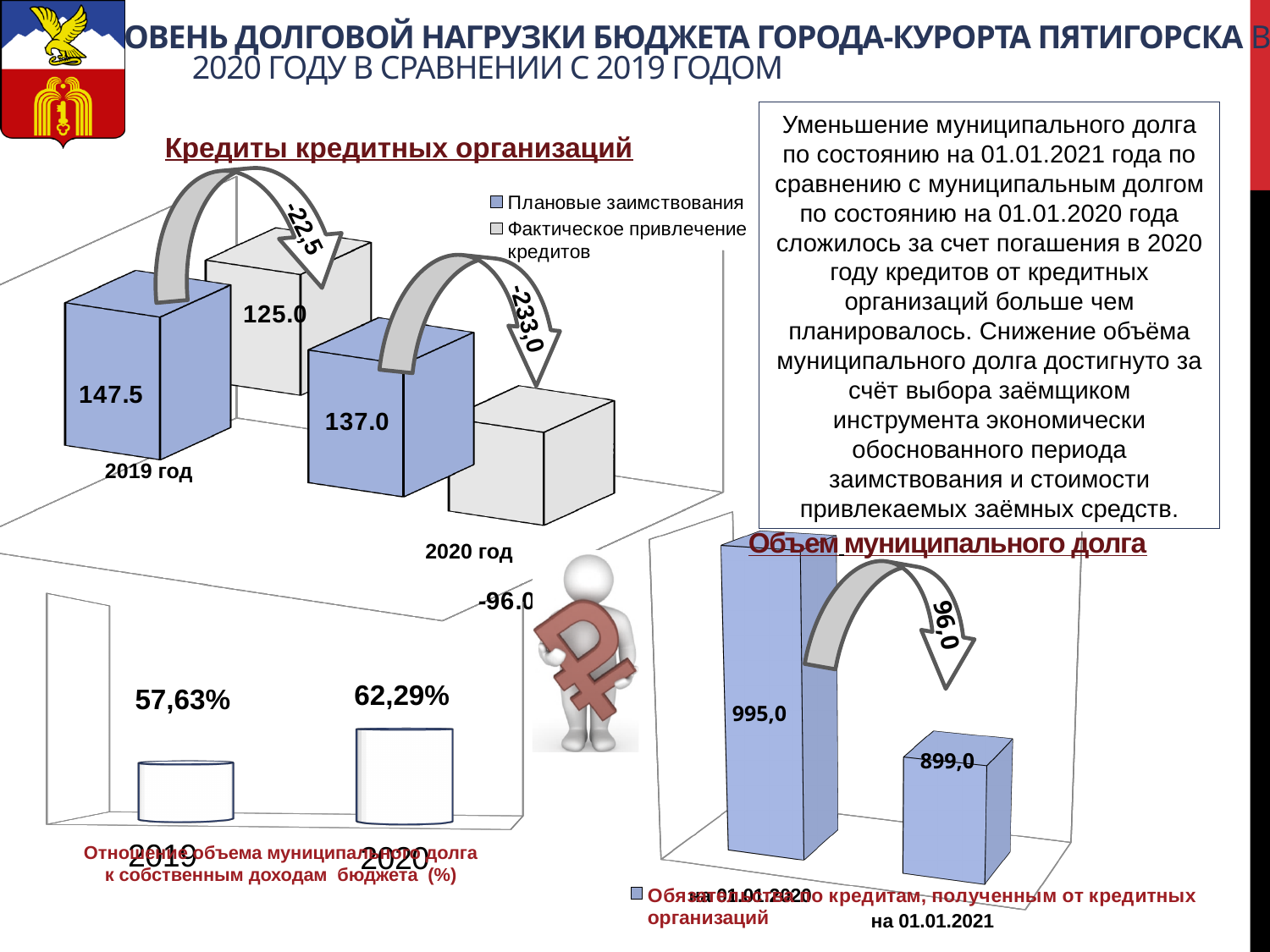
In the chart 'Объем муниципального долга', what is the value for 'на 01.01.2020'? 995,0 In the bottom-left chart 'Отношение объема муниципального долга к собственным доходам бюджета (%)', what is the value for 2019? 57,63% In the chart 'Объем муниципального долга', what is the value for 'на 01.01.2021'? 899,0 In the chart 'Кредиты кредитных организаций', what is the value of 'Плановые заимствования' for 2019 год? 147.5 In the chart 'Объем муниципального долга', by how much did the value decrease from 'на 01.01.2020' to 'на 01.01.2021'? 96,0 In the chart 'Кредиты кредитных организаций', what is the value of 'Плановые заимствования' for 2020 год? 137.0 In the bottom-left chart 'Отношение объема муниципального долга к собственным доходам бюджета (%)', what is the value for 2020? 62,29% How many series does the legend of the chart 'Кредиты кредитных организаций' list? 2 In the chart 'Кредиты кредитных организаций', what is the value of 'Фактическое привлечение кредитов' for 2019 год? 125.0 In the bottom-left chart 'Отношение объема муниципального долга к собственным доходам бюджета (%)', which year has the larger value, 2019 or 2020? 2020 In the chart 'Кредиты кредитных организаций', what is the difference between planned borrowings and actual credits attracted in 2019 год? 22.5 What kind of chart is 'Объем муниципального долга'? Bar chart